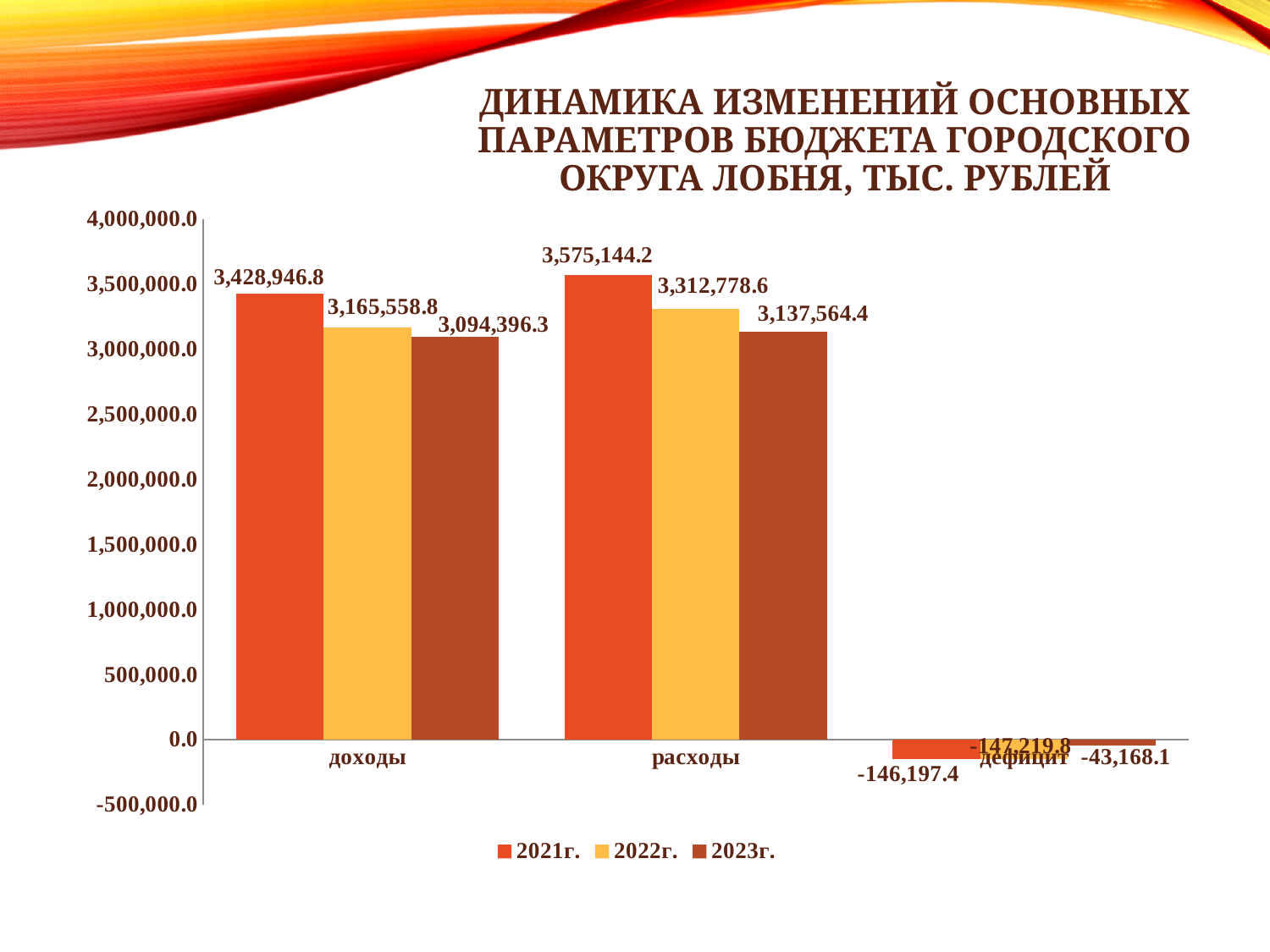
What is the difference between доходы in 2021г. and доходы in 2022г.? 263,388.0 What is the value for расходы in 2022г.? 3,312,778.6 What is the value for доходы in 2023г.? 3,094,396.3 How many series does the legend list? 3 What type of chart is shown on the slide? bar chart What is the value for доходы in 2021г.? 3,428,946.8 What is the difference between расходы in 2022г. and расходы in 2023г.? 175,214.2 Which year has the lowest value for доходы? 2023г. What is the value for дефицит in 2023г.? -43,168.1 Which is larger: расходы in 2023г. or доходы in 2021г.? доходы in 2021г. Which year has the highest value for расходы? 2021г. Do the values for доходы rise or fall from 2021г. to 2023г.? fall